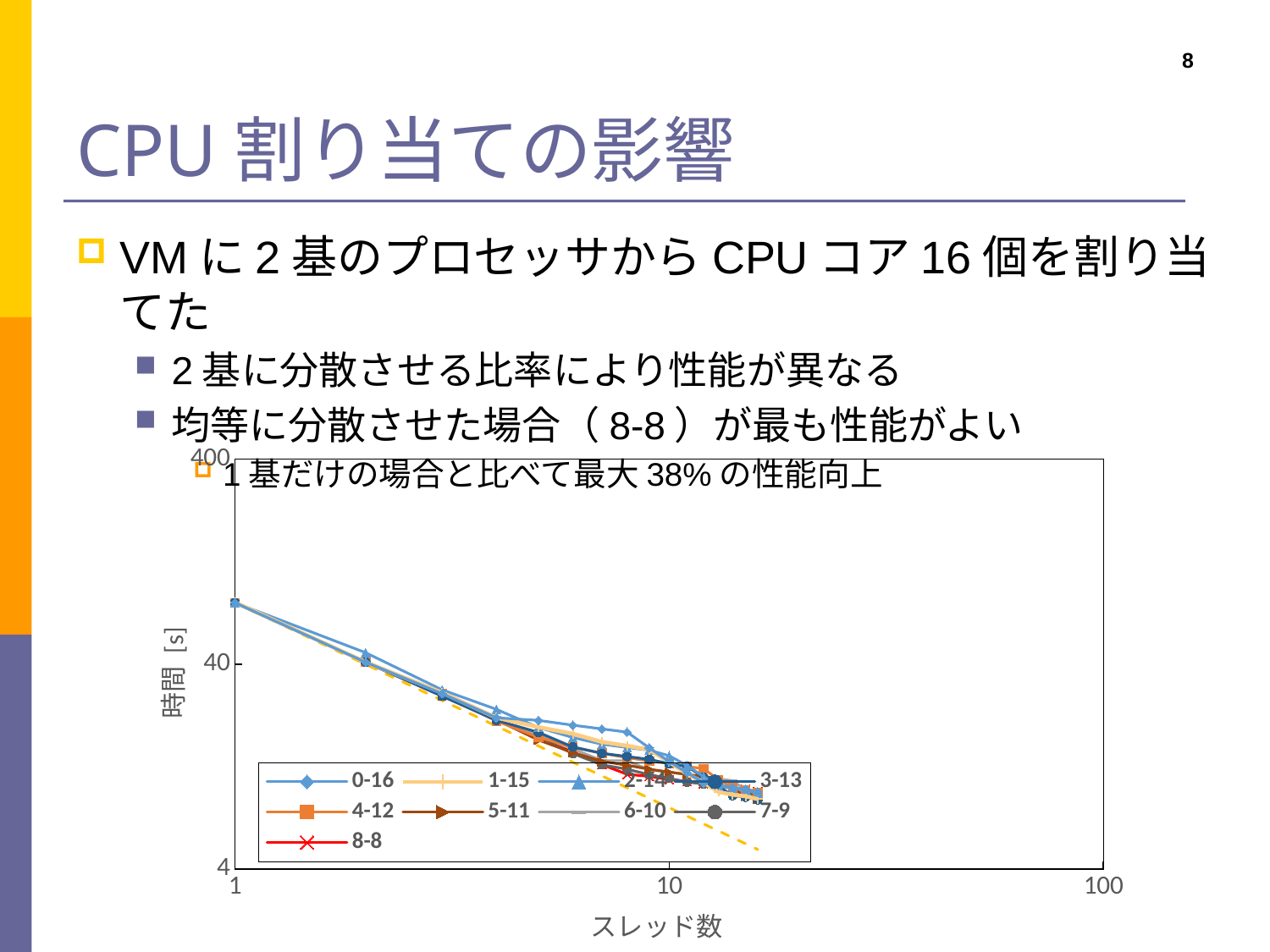
What kind of chart is shown on the slide? line chart Which series has the highest value at around 7 threads? 0-16 Is the value for the 0-16 series at 10 threads greater or less than 4? greater What is the label of the x axis? スレッド数 What is the label of the y axis? 時間 [s] Is the value for the 0-16 series at 1 thread greater or less than 400? less Is the value for the 8-8 series at 10 threads greater or less than 40? less As the number of threads (スレッド数) increases, do the plotted times rise or fall? fall How many series does the chart's legend list? 9